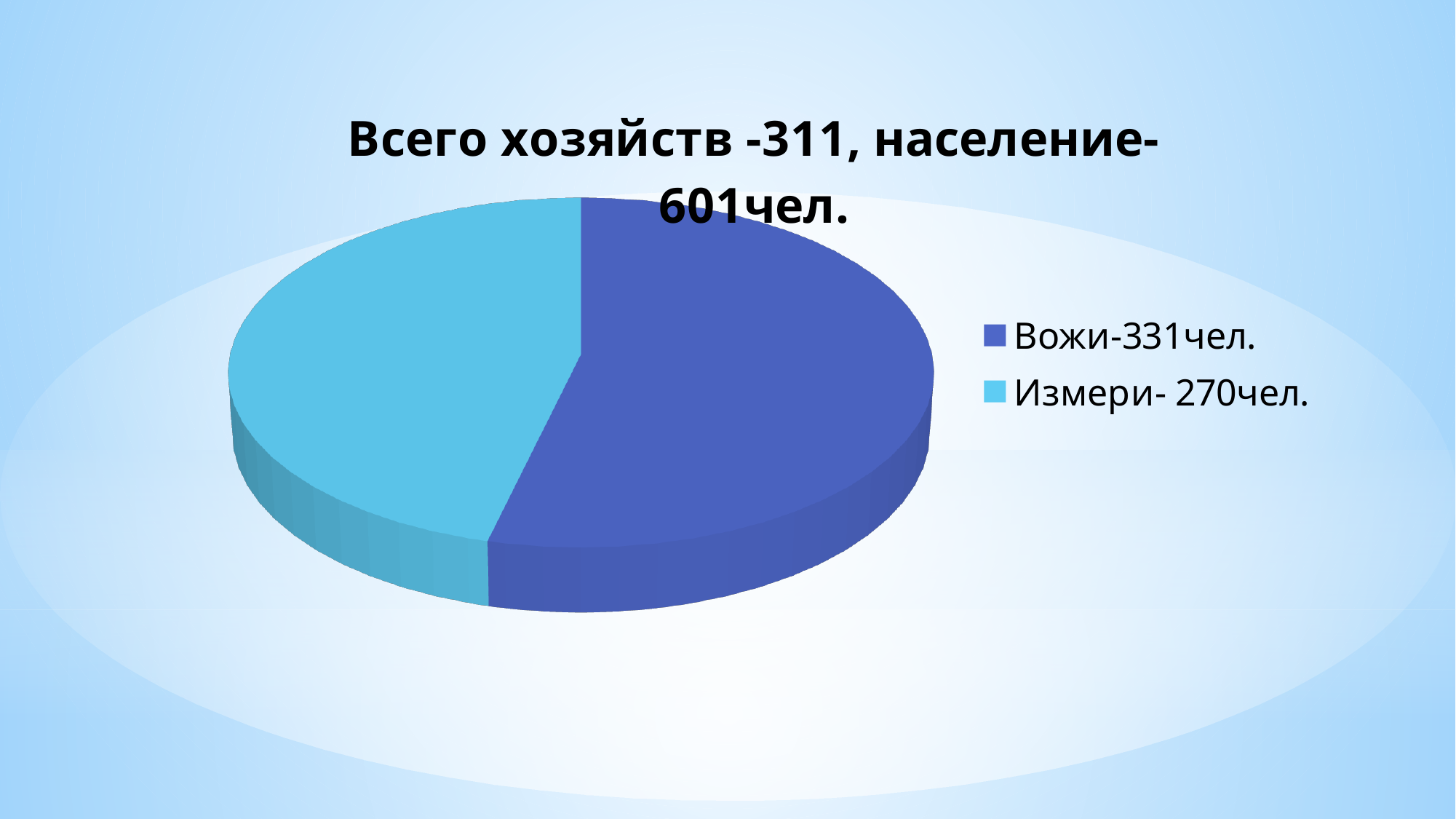
What is the population value given for Измери in the legend? 270чел. Which has a larger population, Вожи or Измери? Вожи What kind of chart is shown on the slide? pie chart Which slice of the pie is the smallest? Измери What is the difference between the population of Вожи and Измери? 61 How many entries does the legend list? 2 What is the total population of Вожи and Измери combined? 601 What is the title of the chart? Всего хозяйств -311, население- 601чел. Which colour represents Измери in the pie chart? light blue Which slice of the pie is the largest? Вожи What is the population value given for Вожи in the legend? 331чел. How many slices does the pie chart have? 2